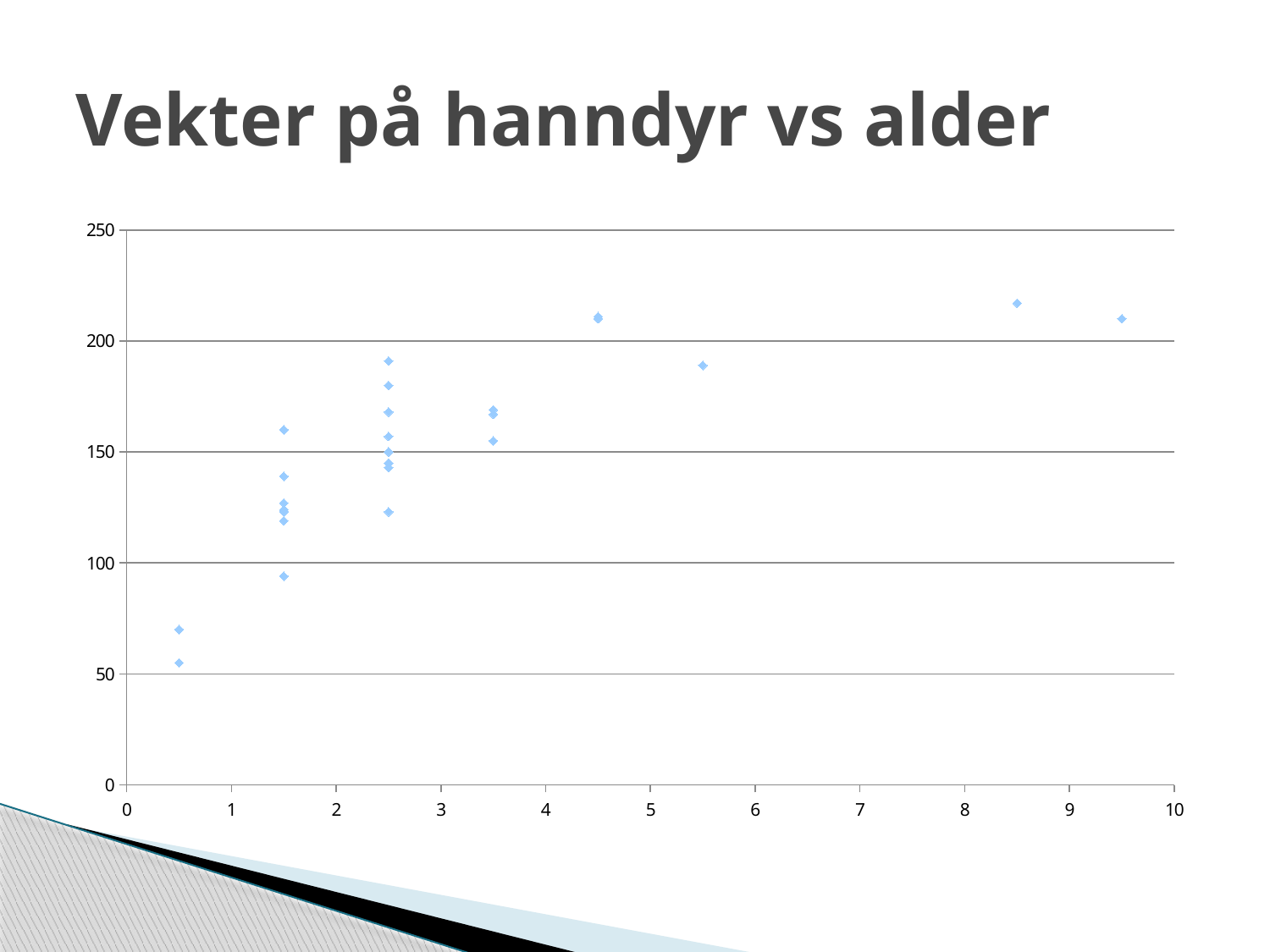
Are the values plotted at x = 0.5 greater or less than 100? less Is the value plotted at x = 5.5 greater or less than 150? greater Is the value plotted at x = 8.5 greater or less than 200? greater What is the title of the chart? Vekter på hanndyr vs alder Which is larger: the value plotted at x = 4.5 or the value plotted at x = 5.5? x = 4.5 Do the plotted values generally rise or fall as the x-axis value increases? rise What kind of chart is shown on the slide? scatter plot What is the maximum value shown on the y-axis? 250 How many distinct x-axis positions have plotted points? 8